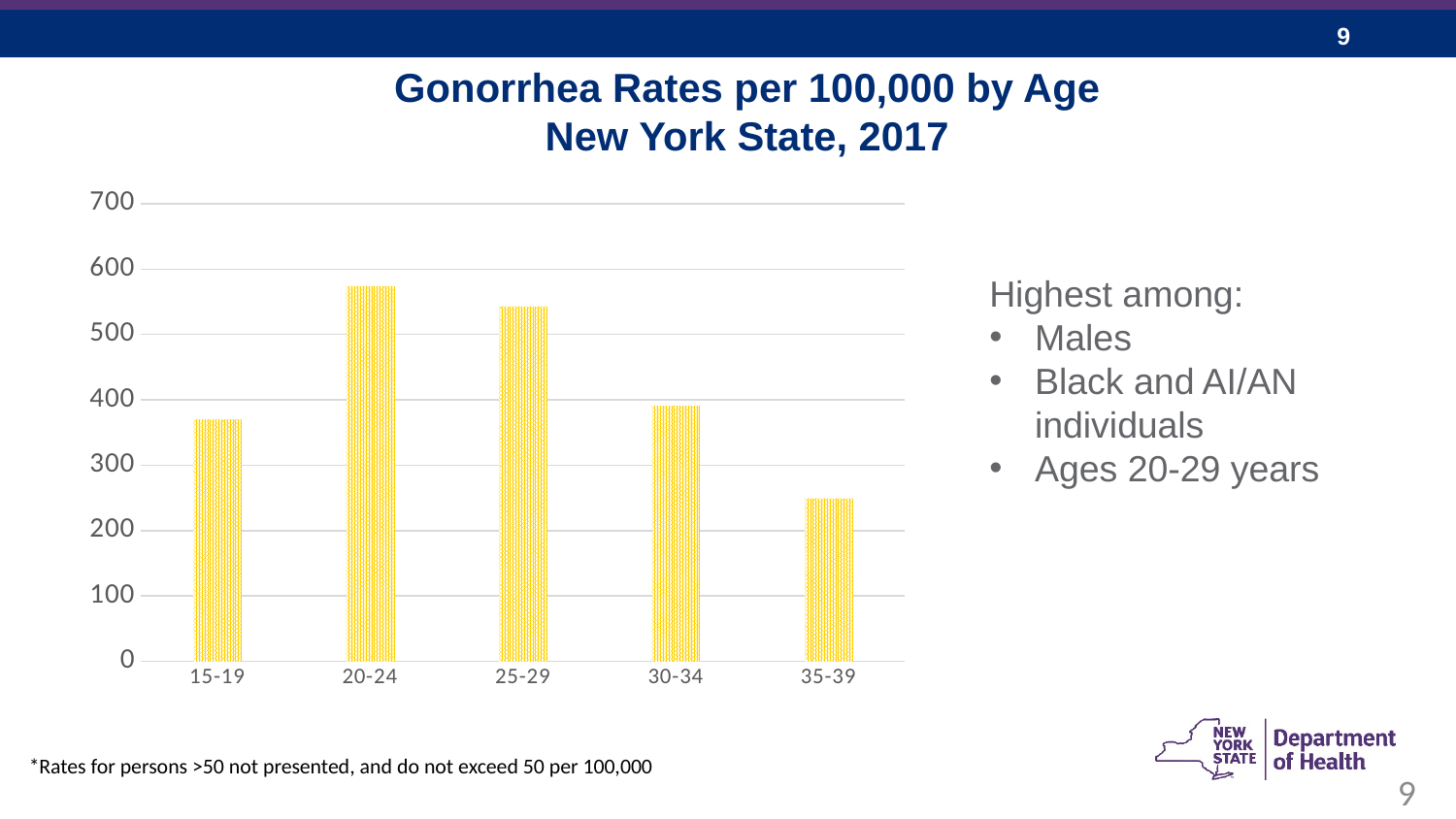
What kind of chart is shown on the slide? bar chart Which age group has the lowest gonorrhea rate in the chart? 35-39 What is the title of the chart on the slide? Gonorrhea Rates per 100,000 by Age New York State, 2017 Is the value for the 25-29 age group greater or less than 500? greater Is the value for the 30-34 age group greater or less than 300? greater Is the value for the 15-19 age group greater or less than 400? less Which has a higher gonorrhea rate, the 25-29 age group or the 30-34 age group? 25-29 How many age groups are shown on the x axis of the chart? 5 Which age group has the highest gonorrhea rate in the chart? 20-24 Do the values rise or fall along the x axis from the 25-29 age group to the 35-39 age group? fall